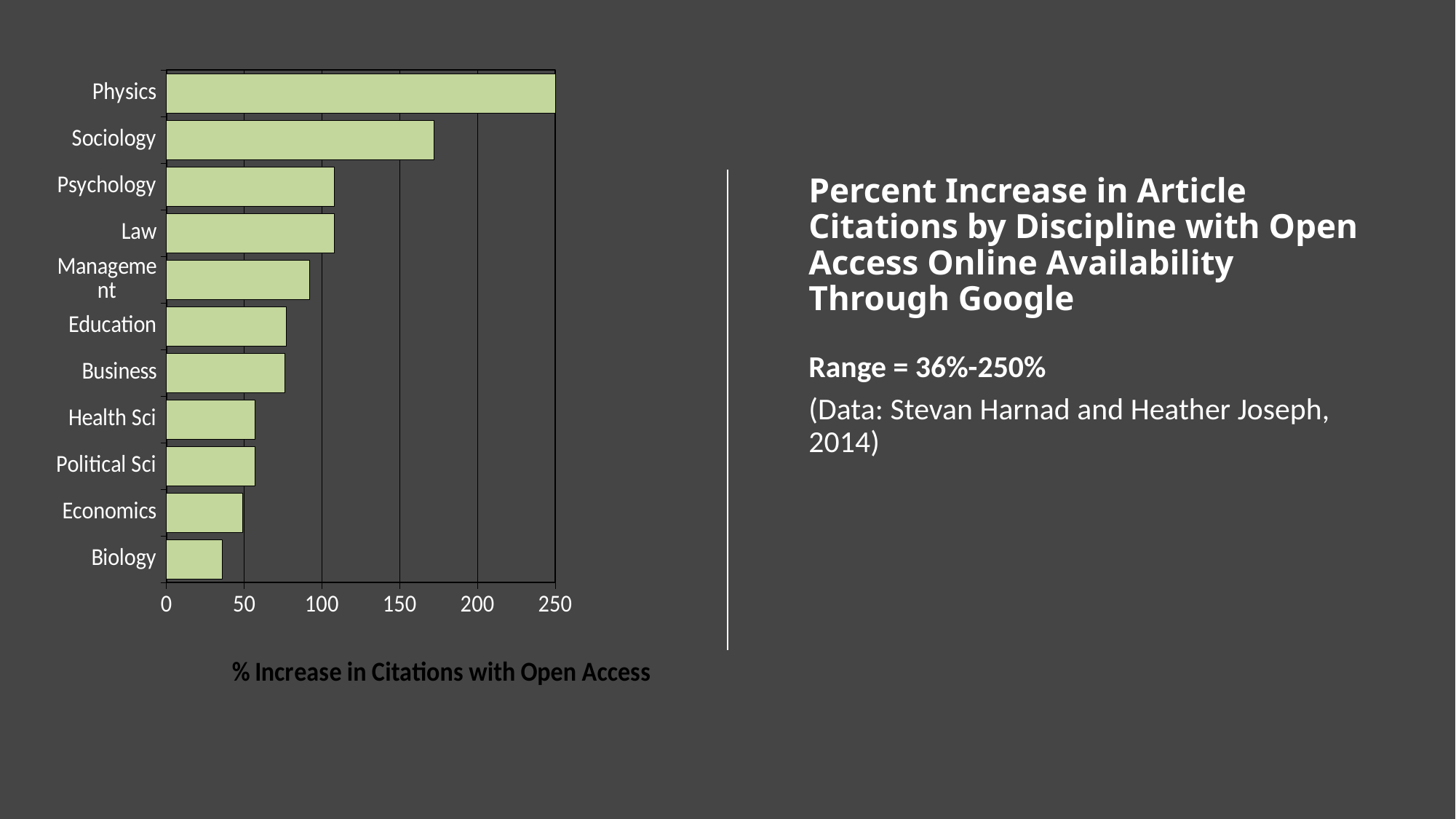
What is the percent increase in citations for Physics? 250 Which discipline has the lowest percent increase in citations? Biology Is the value for Education greater or less than 50? greater What is the title of the horizontal axis of the chart? % Increase in Citations with Open Access Which has a larger percent increase in citations, Sociology or Psychology? Sociology Which discipline has the highest percent increase in citations? Physics Which has a larger percent increase in citations, Business or Economics? Business Is the value for Management greater or less than 100? less Is the value for Biology greater or less than 50? less How many disciplines are plotted in the chart? 11 What kind of chart is shown on the slide? bar chart